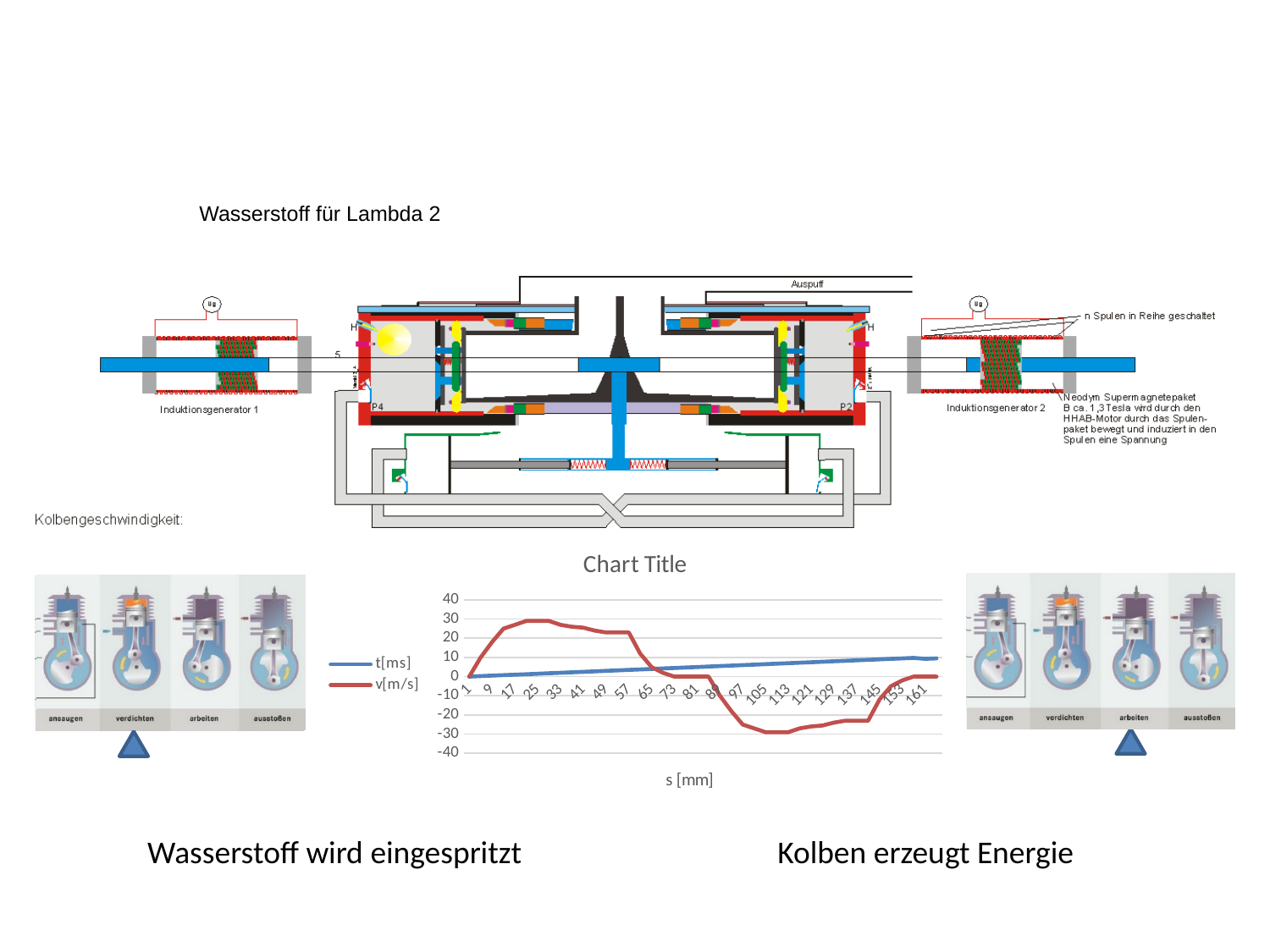
How many series does the chart legend list? 2 At s = 25, which series has the larger value, t[ms] or v[m/s]? v[m/s] At s = 113, which series has the larger value, t[ms] or v[m/s]? t[ms] What are the two series named in the chart legend? t[ms] and v[m/s] Is the value of v[m/s] at s = 113 greater or less than 0? less What is the highest value shown on the chart's y axis? 40 Is the value of v[m/s] at s = 25 greater or less than 20? greater What kind of chart is shown on the slide? line chart What is the label of the chart's x axis? s [mm] Is the value of v[m/s] at s = 105 greater or less than -20? less Does the t[ms] series rise or fall as s increases along the x axis? rise